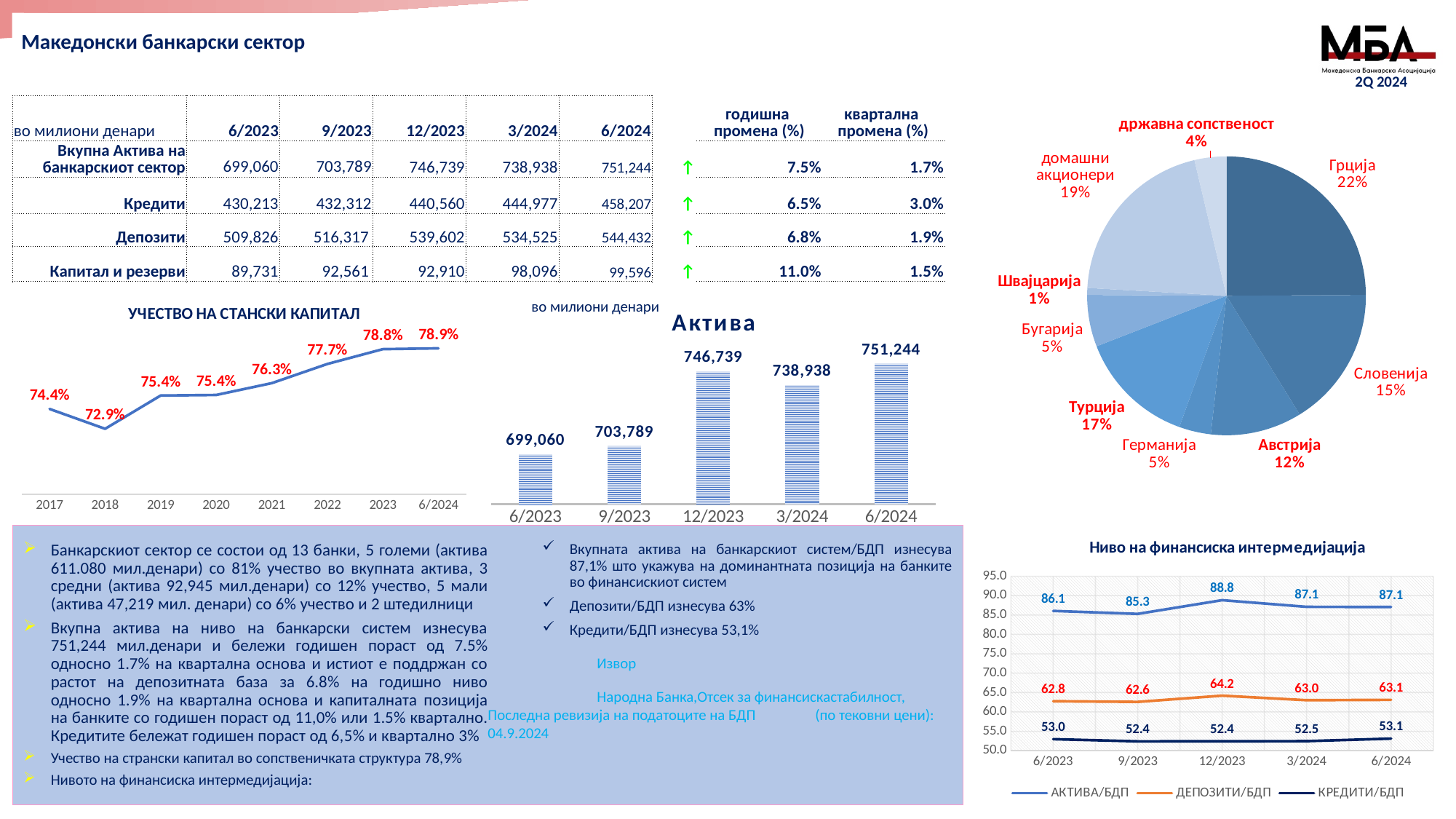
In the 'Ниво на финансиска интермедијација' chart, what is the value of ДЕПОЗИТИ/БДП for 12/2023? 64.2 In the 'Актива' bar chart, what is the difference between the 12/2023 and 3/2024 values? 7,801 In the 'Актива' bar chart, which period has the lowest value? 6/2023 In the pie chart on the right, which slice is the smallest? Швајцарија In the 'Актива' bar chart, what is the value for 6/2024? 751,244 In the 'Актива' bar chart, how many bars are shown? 5 In the 'УЧЕСТВО НА СТАНСКИ КАПИТАЛ' line chart, which year has the lowest value? 2018 In the 'УЧЕСТВО НА СТАНСКИ КАПИТАЛ' line chart, what is the difference between the 6/2024 and 2017 values? 4.5% In the pie chart on the right, what share does Грција have? 22% In the 'Ниво на финансиска интермедијација' chart, how many series does the legend list? 3 In the pie chart on the right, which is larger: Турција or Словенија? Турција In the 'УЧЕСТВО НА СТАНСКИ КАПИТАЛ' line chart, what is the value for 2018? 72.9%